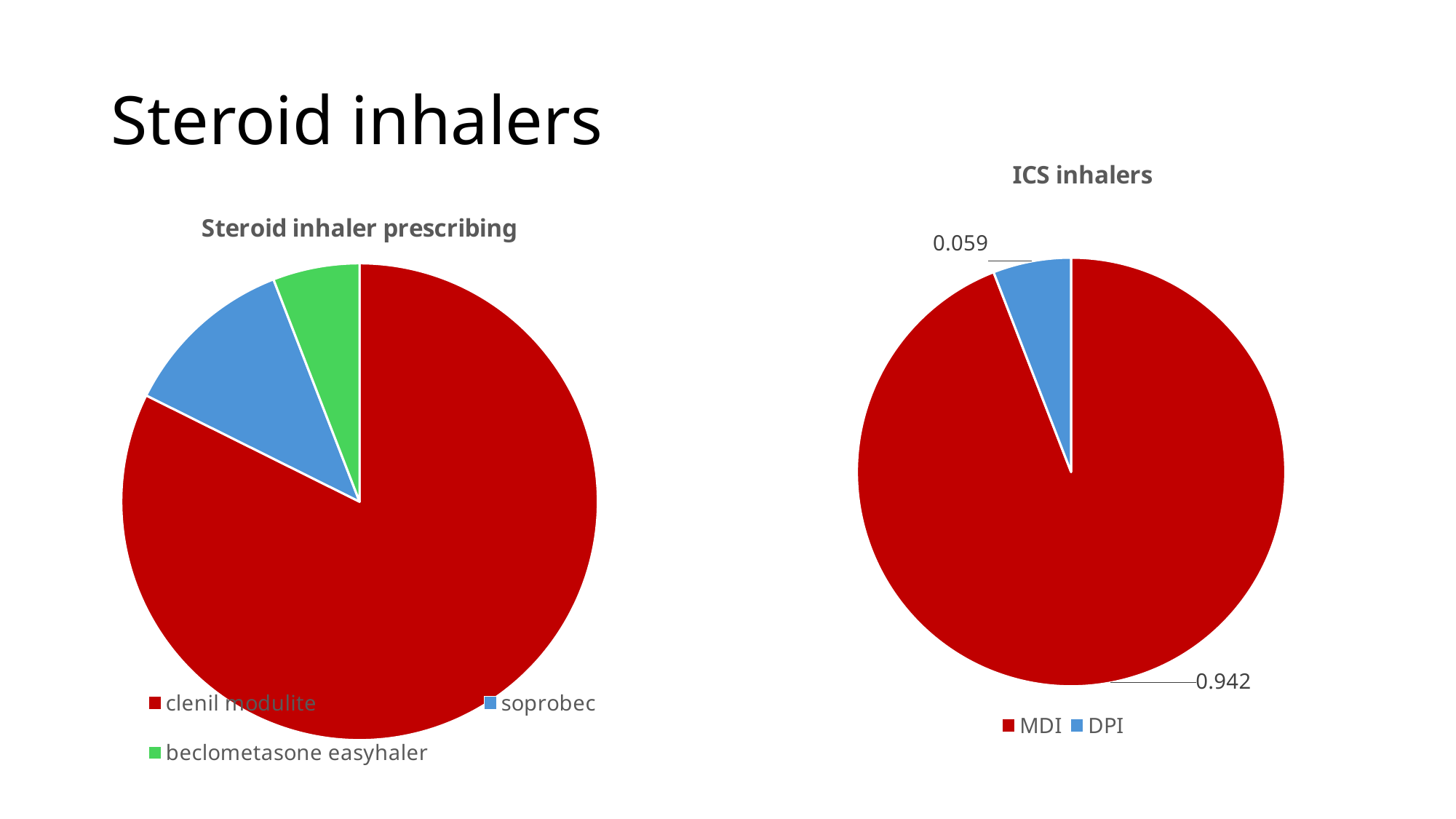
In the 'Steroid inhaler prescribing' chart, which category has the largest slice? clenil modulite In the 'ICS inhalers' chart, what is the difference between the MDI and DPI values? 0.883 In the 'Steroid inhaler prescribing' chart, what kind of chart is shown? pie chart In the 'Steroid inhaler prescribing' chart, which category has the smallest slice? beclometasone easyhaler In the 'Steroid inhaler prescribing' chart, what colour is the soprobec slice? blue What is the title of the chart on the right side of the slide? ICS inhalers In the 'ICS inhalers' chart, how many categories does the legend list? 2 In the 'ICS inhalers' chart, which category has the largest slice? MDI In the 'ICS inhalers' chart, what is the value for MDI? 0.942 In the 'Steroid inhaler prescribing' chart, which slice is larger: soprobec or beclometasone easyhaler? soprobec In the 'ICS inhalers' chart, what is the value for DPI? 0.059 In the 'Steroid inhaler prescribing' chart, how many categories does the legend list? 3